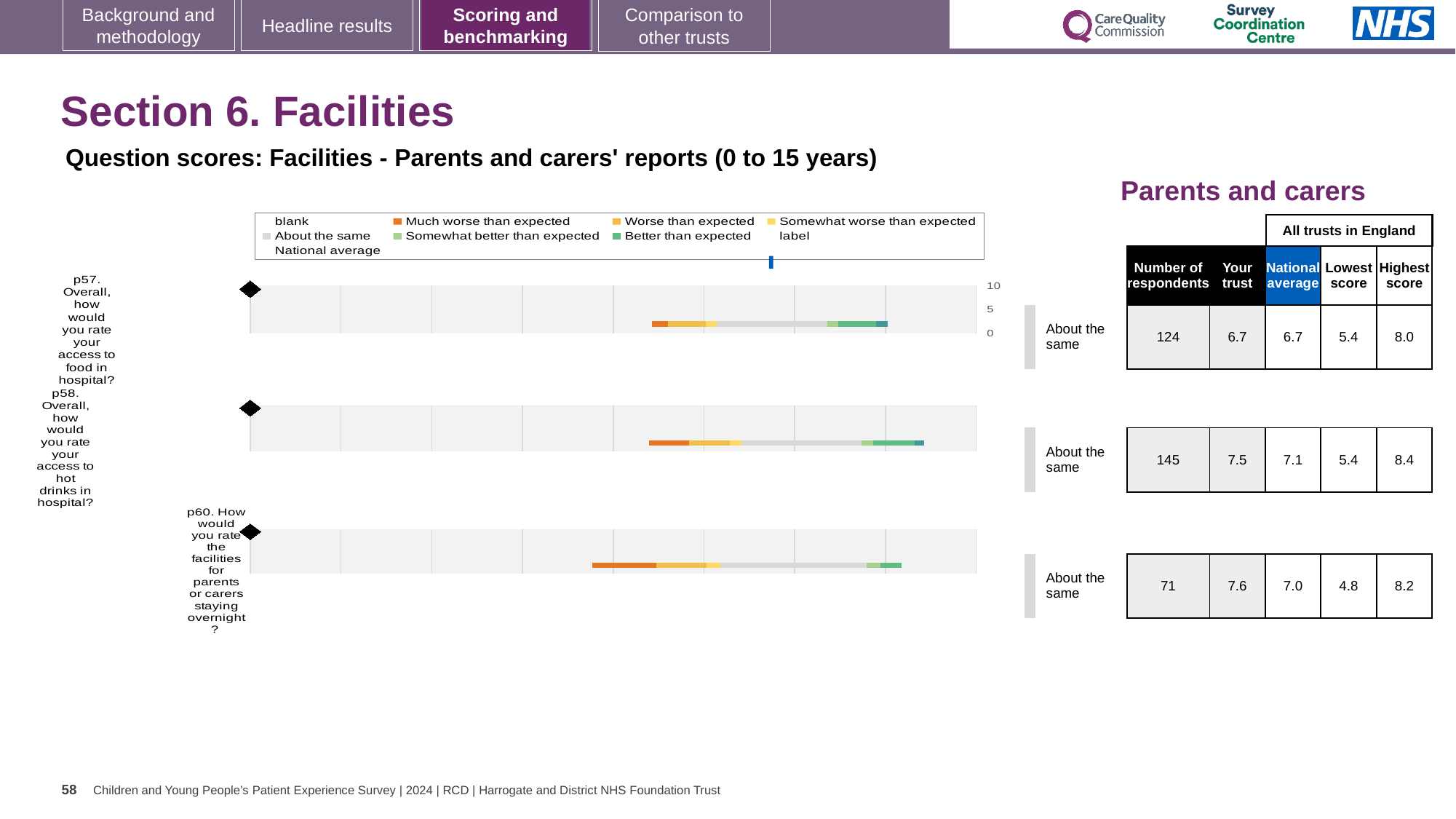
What benchmark category is shown for all three questions on this slide? About the same How many respondents answered p60 (facilities for parents or carers staying overnight)? 71 What is the highest score across all trusts in England for p60? 8.2 Which question has the fewest respondents? p60. How would you rate the facilities for parents or carers staying overnight? What is the maximum value shown on the chart's score axis? 10 Which question has the highest 'Your trust' score? p60. How would you rate the facilities for parents or carers staying overnight? What is the national average score for p58 (access to hot drinks in hospital)? 7.1 For p58, is the 'Your trust' score or the national average larger? Your trust How many questions (categories) are plotted on the Facilities chart? 3 What is the 'Your trust' score for p57 (access to food in hospital)? 6.7 What is the difference between the highest score and the lowest score for p58? 3.0 What kind of chart is used to show the question scores for Facilities? bar chart